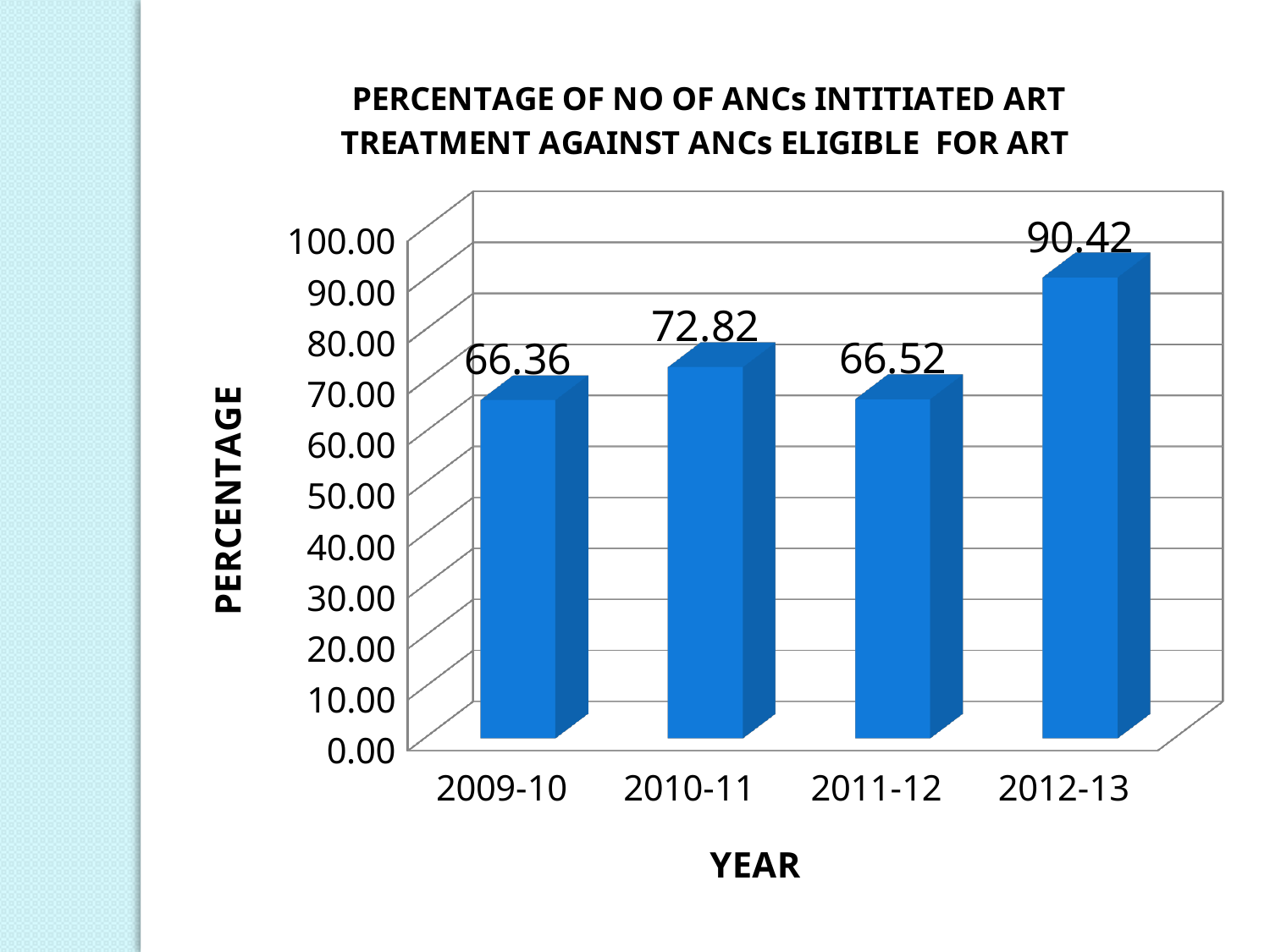
What kind of chart is this? bar chart Is the value for 2012-13 greater or less than 80.00? greater What is the value for 2011-12? 66.52 What is the value for 2010-11? 72.82 How many years are shown on the x axis? 4 What is the difference between the values for 2012-13 and 2010-11? 17.60 Which year has the lowest value? 2009-10 What is the label of the y axis? PERCENTAGE Which is larger, the value for 2010-11 or the value for 2011-12? 2010-11 Which year has the highest value? 2012-13 What is the value for 2012-13? 90.42 What is the value for 2009-10? 66.36